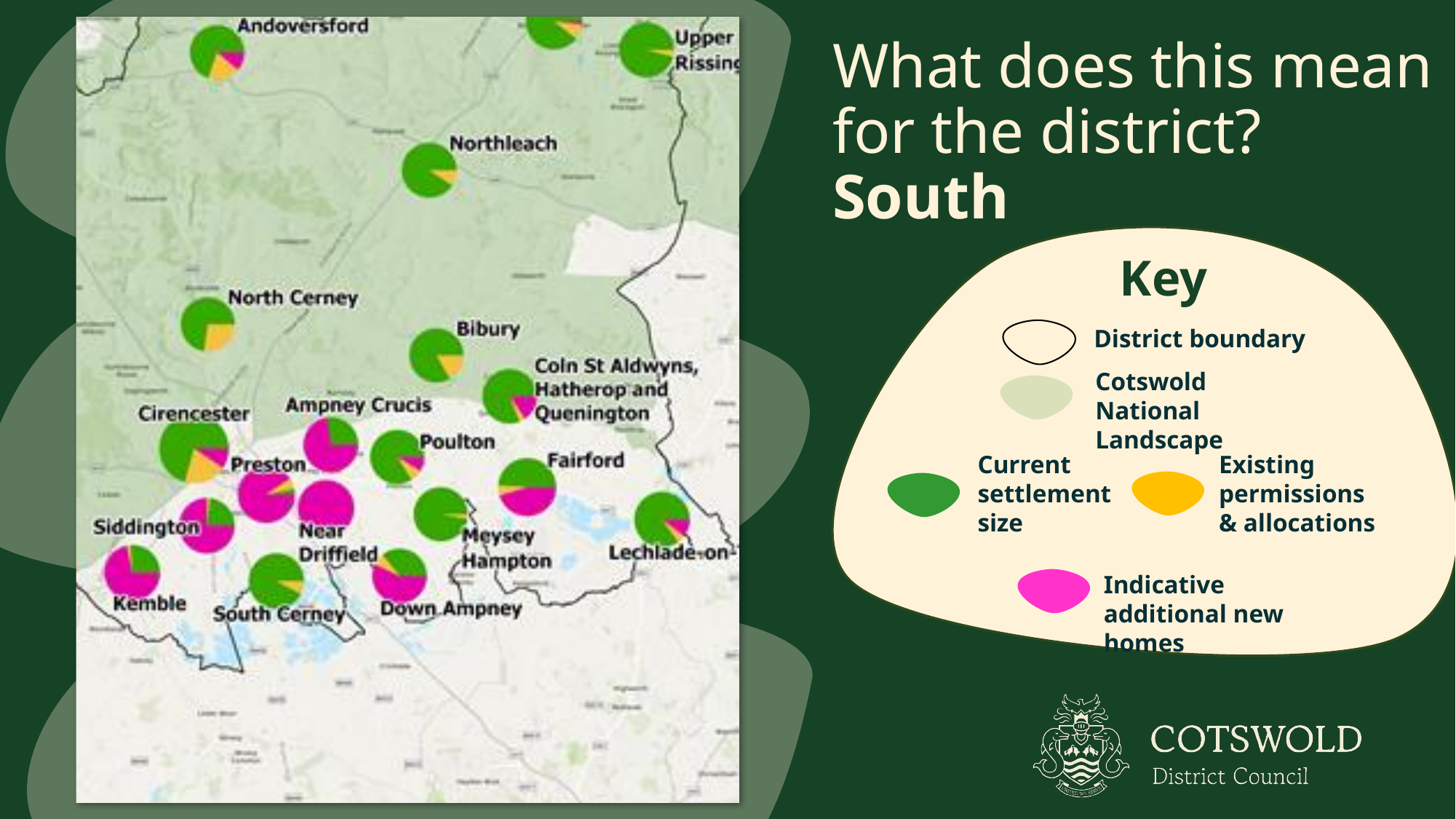
Which settlement's pie chart is entirely pink (indicative additional new homes)? Near Driffield How many categories does the key list for the pie chart segments? 3 Which has the larger share of current settlement size (green), Upper Rissing or Kemble? Upper Rissing Which has the larger share of indicative additional new homes (pink), Near Driffield or Northleach? Near Driffield What kind of chart is used on the map to show each settlement? Pie chart Which colour represents 'Current settlement size' in the key? Green Which has the larger share of indicative additional new homes (pink), Preston or Bibury? Preston Which colour represents 'Indicative additional new homes' in the key? Pink